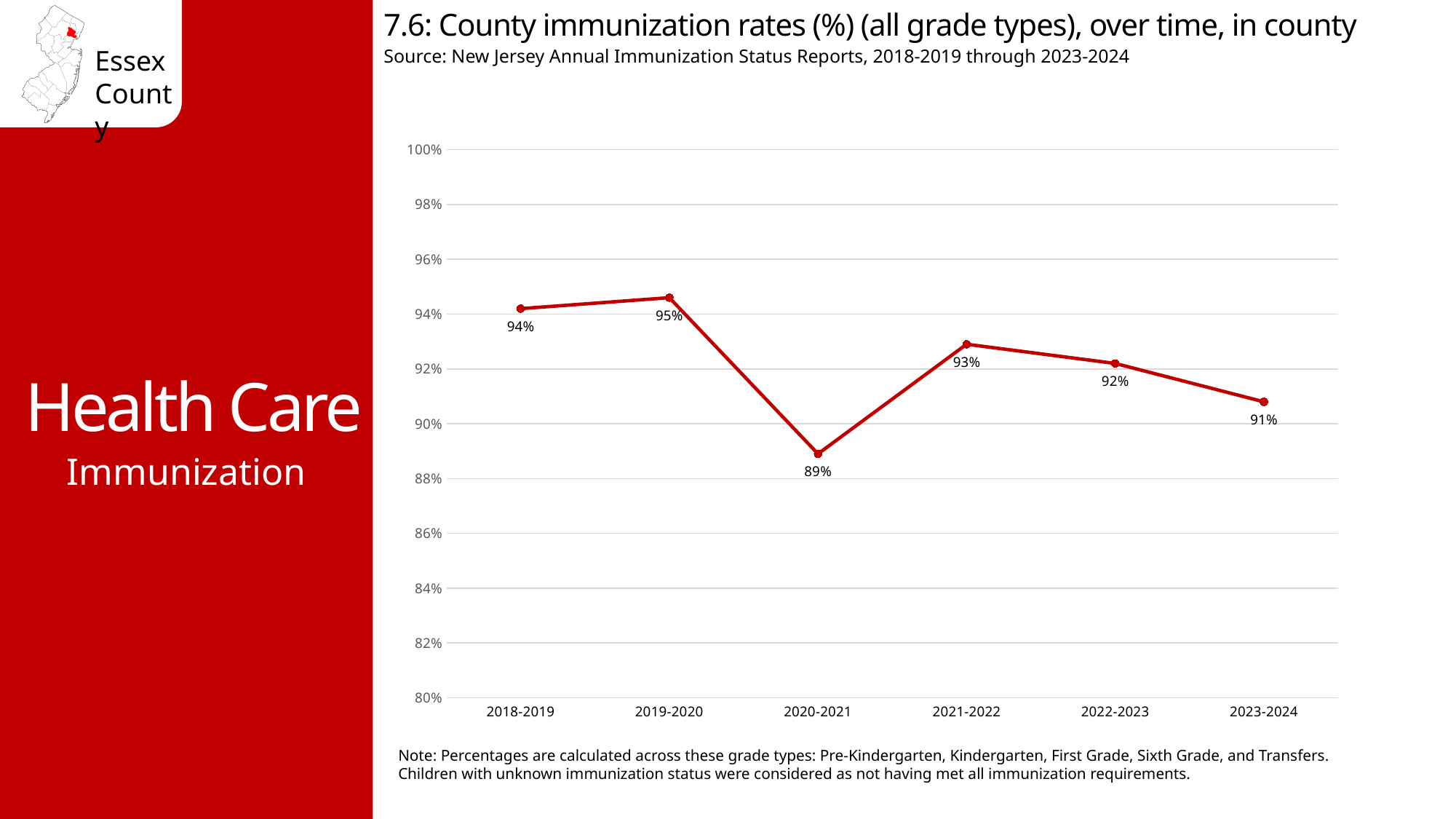
Did the immunization rate rise or fall from 2021-2022 to 2023-2024? fall Which school year had the lowest immunization rate? 2020-2021 What was the county immunization rate in 2023-2024? 91% What kind of chart is shown on the slide? line chart Which year had a higher immunization rate, 2018-2019 or 2022-2023? 2018-2019 What was the county immunization rate in 2020-2021? 89% How many school years are plotted on the chart? 6 What was the county immunization rate in 2021-2022? 93% What is the difference in immunization rate between 2019-2020 and 2020-2021, using the printed labels? 6% Which school year had the highest immunization rate? 2019-2020 Is the immunization rate for 2020-2021 greater or less than 90%? less What was the county immunization rate in 2018-2019? 94%